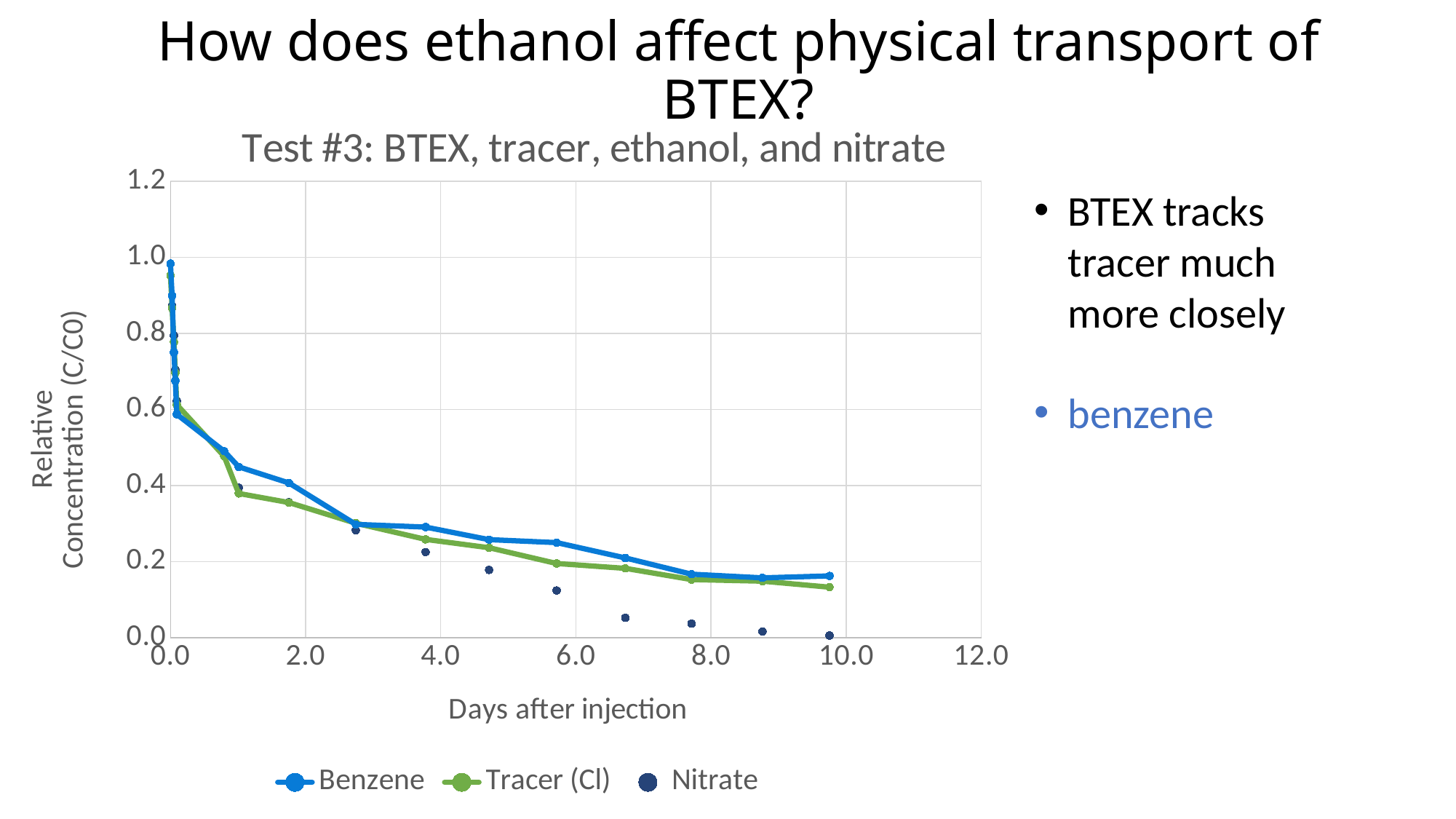
At about 8 days after injection, which is larger: Benzene or Nitrate? Benzene Is the Benzene value at about 6 days after injection greater or less than 0.2? greater How many series does the legend list? 3 Which series has the lowest value at about 10 days after injection? Nitrate What is the title of the chart? Test #3: BTEX, tracer, ethanol, and nitrate What kind of chart is shown on the slide? line chart Do the Benzene values rise or fall as days after injection increase? fall What is the label of the x axis? Days after injection At about 6 days after injection, which is larger: Benzene or Tracer (Cl)? Benzene Is the Benzene value at about 10 days after injection greater or less than 0.2? less Is the Nitrate value at about 10 days after injection greater or less than 0.2? less